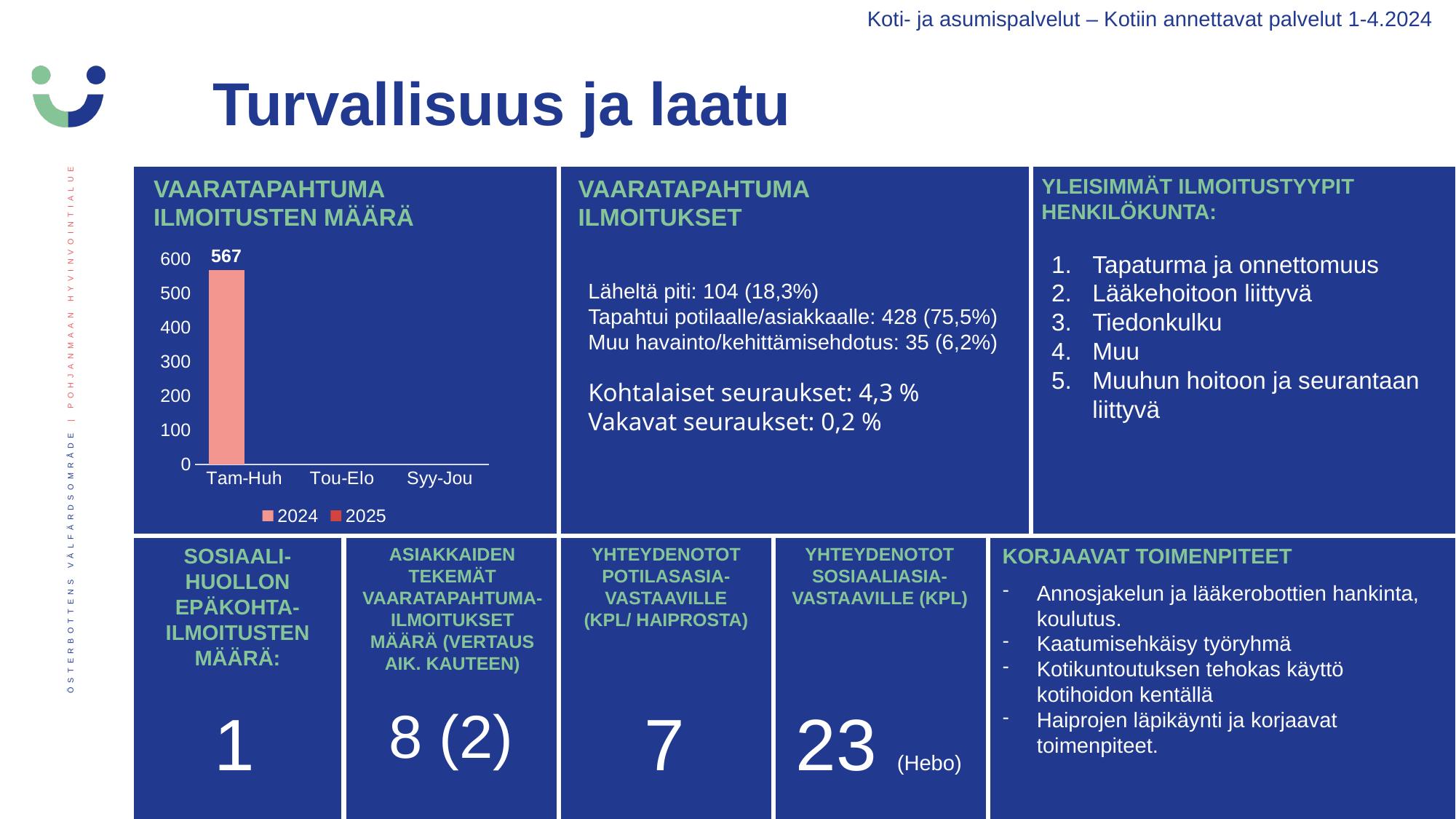
How many series does the chart legend list? 2 What is the value of the 2024 bar for Tam-Huh in the chart? 567 What is the highest tick value shown on the y axis of the chart? 600 What are the series names listed in the chart legend? 2024 and 2025 What kind of chart is shown on the slide? bar chart Is the value for Tam-Huh greater or less than 500? greater How many categories are shown on the x axis of the chart? 3 What is the title of the chart? VAARATAPAHTUMA ILMOITUSTEN MÄÄRÄ Which category has the highest value in the chart? Tam-Huh Which category is listed last on the x axis of the chart? Syy-Jou